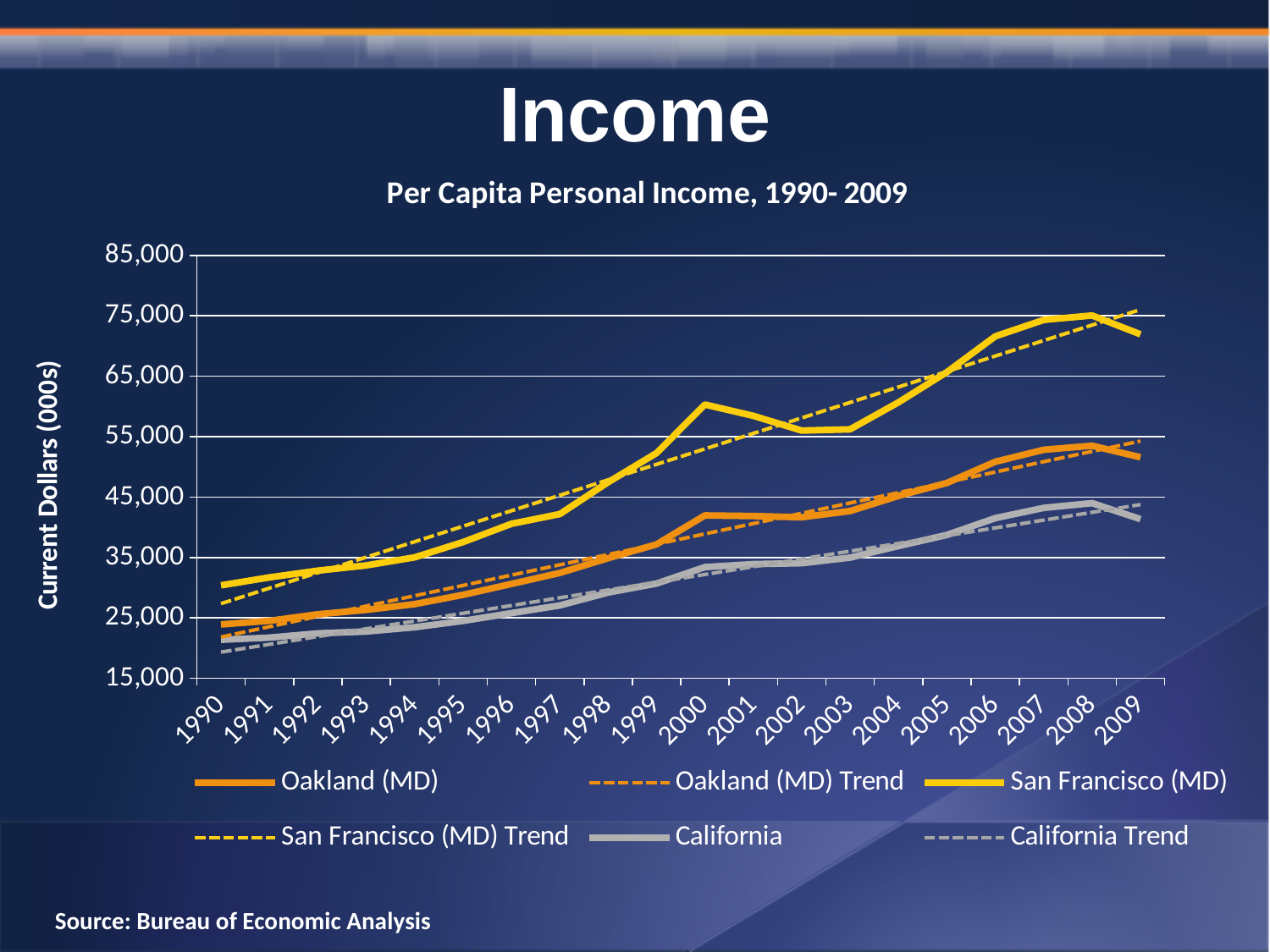
What is the label on the vertical axis of the chart? Current Dollars (000s) Is the value for San Francisco (MD) in 2009 greater or less than 65,000? greater Does per capita personal income for Oakland (MD) generally rise or fall from 1990 to 2009? rise Which series has the lowest per capita personal income in 2009? California Is the value for San Francisco (MD) in 2000 greater or less than 55,000? greater What kind of chart is shown on the slide? line chart How many series does the legend list? 6 How many years are plotted along the x axis? 20 Which series has the highest per capita personal income in 2009? San Francisco (MD) Is the value for California in 2009 greater or less than 45,000? less Which is larger in 2005, the value for Oakland (MD) or the value for California? Oakland (MD)